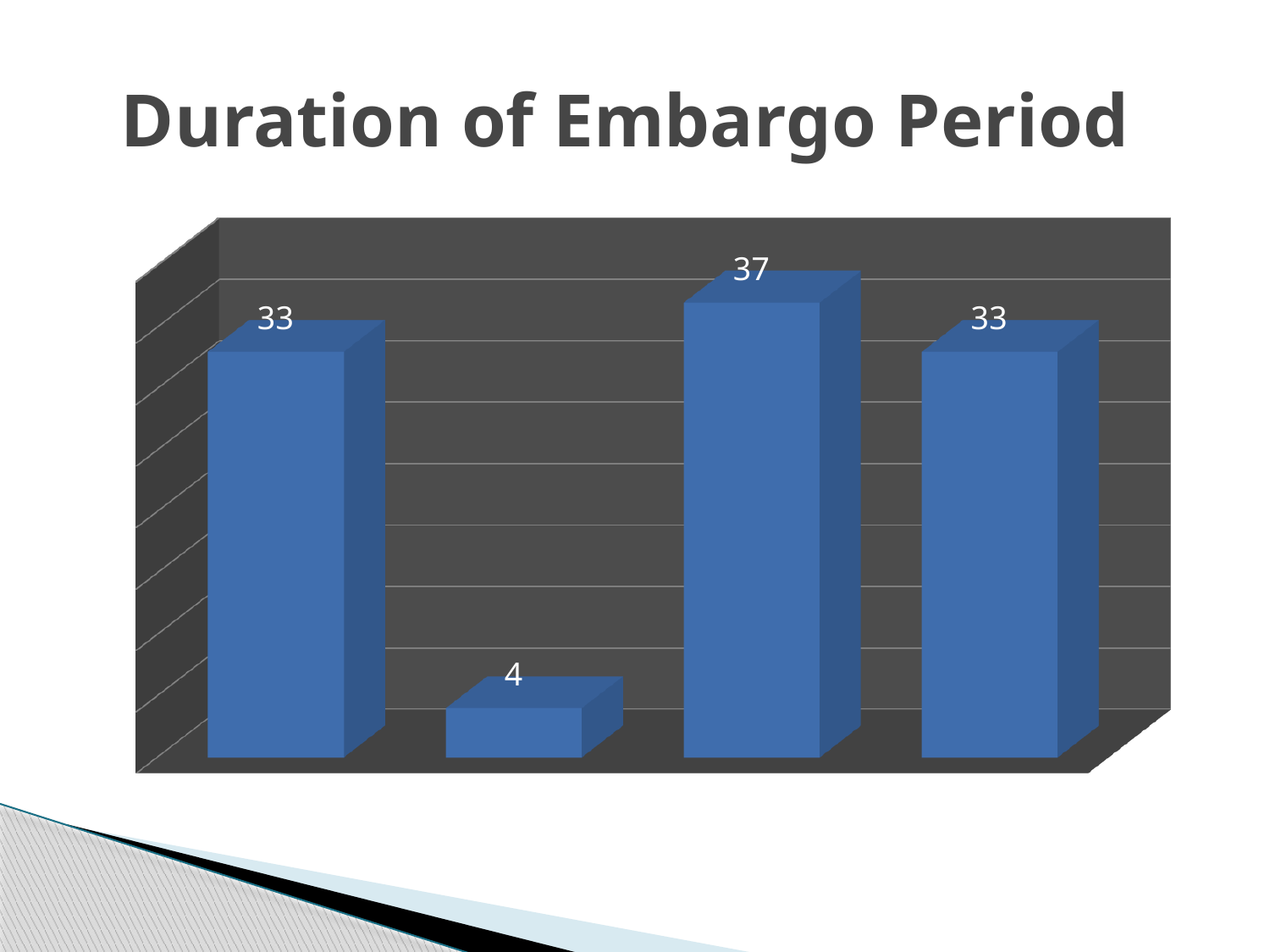
What is the value of the second bar from the left? 4 What is the title of the slide? Duration of Embargo Period What is the lowest value shown on the chart? 4 What is the value of the first (leftmost) bar? 33 What is the value of the third bar from the left? 37 What is the highest value shown on the chart? 37 How many bars are plotted on the chart? 4 What is the value of the fourth (rightmost) bar? 33 What kind of chart is shown on the slide? bar chart What is the difference between the third bar and the first bar? 4 Which is larger, the second bar or the fourth bar? the fourth bar What is the difference between the third bar and the second bar? 33